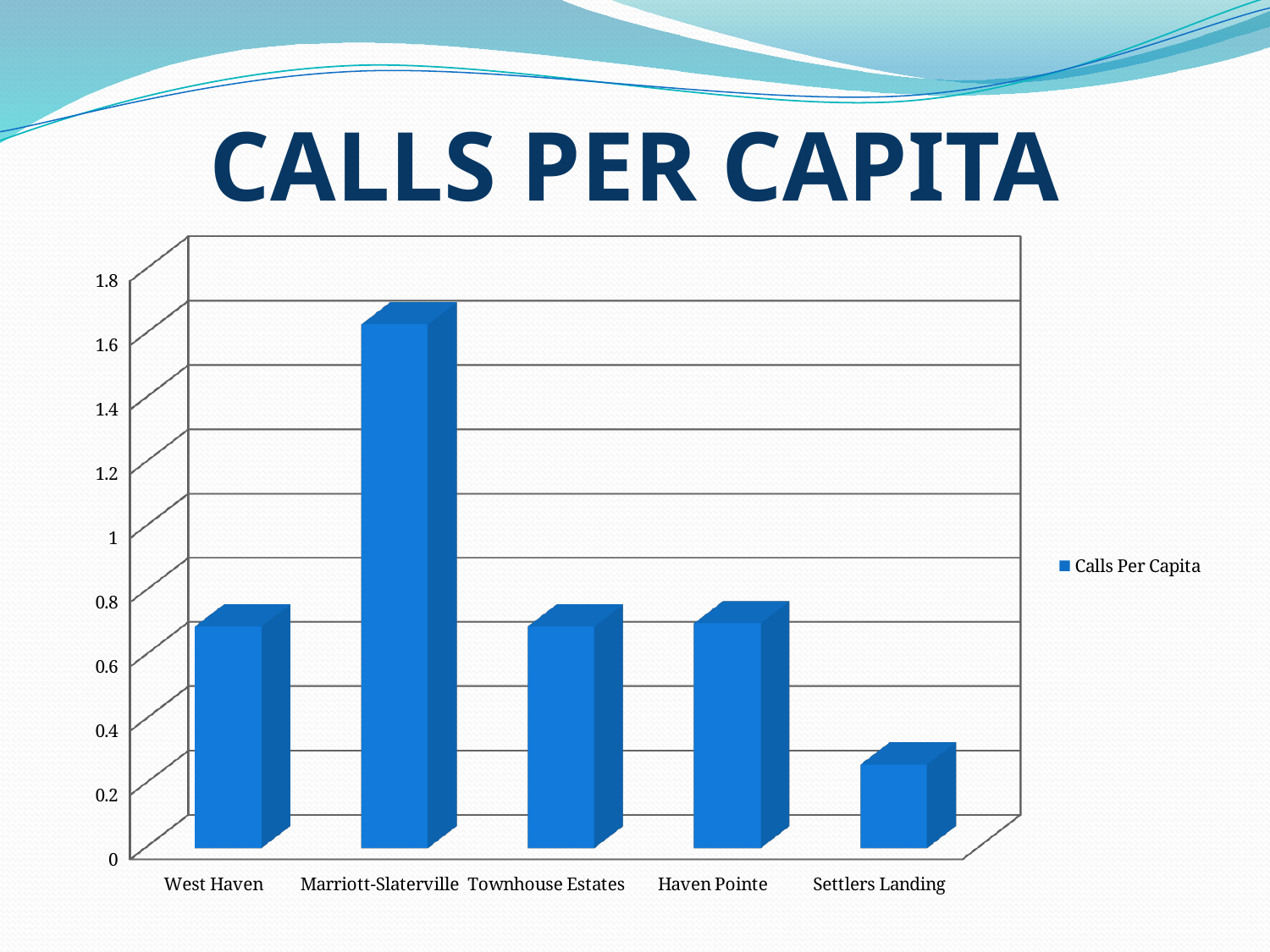
Which has a lower value, Settlers Landing or Haven Pointe? Settlers Landing Is the value for Settlers Landing greater or less than 0.4? less What is the name of the series shown in the legend? Calls Per Capita What is the title of the chart? CALLS PER CAPITA Which category has the lowest calls per capita? Settlers Landing Is the value for West Haven greater or less than 0.6? greater Is the value for Marriott-Slaterville greater or less than 1.4? greater How many series does the legend list? 1 How many categories are shown on the x axis? 5 What kind of chart is shown on the slide? bar chart Which category has the highest calls per capita? Marriott-Slaterville Which has a higher value, Marriott-Slaterville or West Haven? Marriott-Slaterville